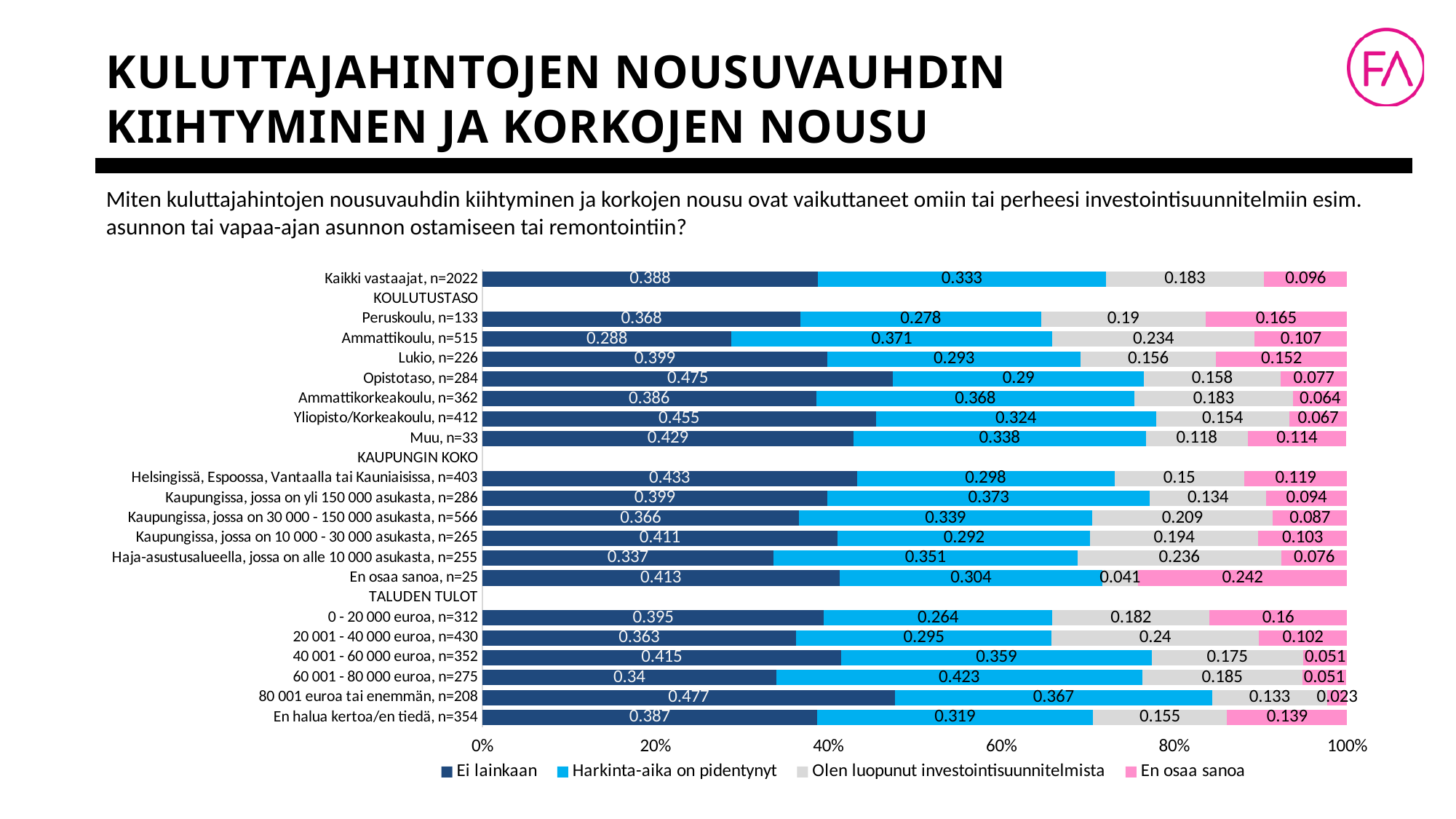
What is the value of "Ei lainkaan" for "Kaikki vastaajat, n=2022"? 0.388 What kind of chart is shown on the slide? Stacked bar chart For "Ammattikoulu, n=515", which is larger: "Ei lainkaan" or "Harkinta-aika on pidentynyt"? Harkinta-aika on pidentynyt Is the "Ei lainkaan" value for "Peruskoulu, n=133" greater or less than 40%? less What is the value of "Olen luopunut investointisuunnitelmista" for "Haja-asutusalueella, jossa on alle 10 000 asukasta, n=255"? 0.236 How many series does the legend list? 4 Which category has the lowest value for "En osaa sanoa"? 80 001 euroa tai enemmän, n=208 What is the value of "Harkinta-aika on pidentynyt" for "Opistotaso, n=284"? 0.29 What colour represents the "Ei lainkaan" series in the legend? Dark blue Which category has the highest value for "En osaa sanoa"? En osaa sanoa, n=25 For "Kaikki vastaajat, n=2022", what is the difference between "Harkinta-aika on pidentynyt" and "Olen luopunut investointisuunnitelmista"? 0.15 What is the value of "Harkinta-aika on pidentynyt" for "60 001 - 80 000 euroa, n=275"? 0.423